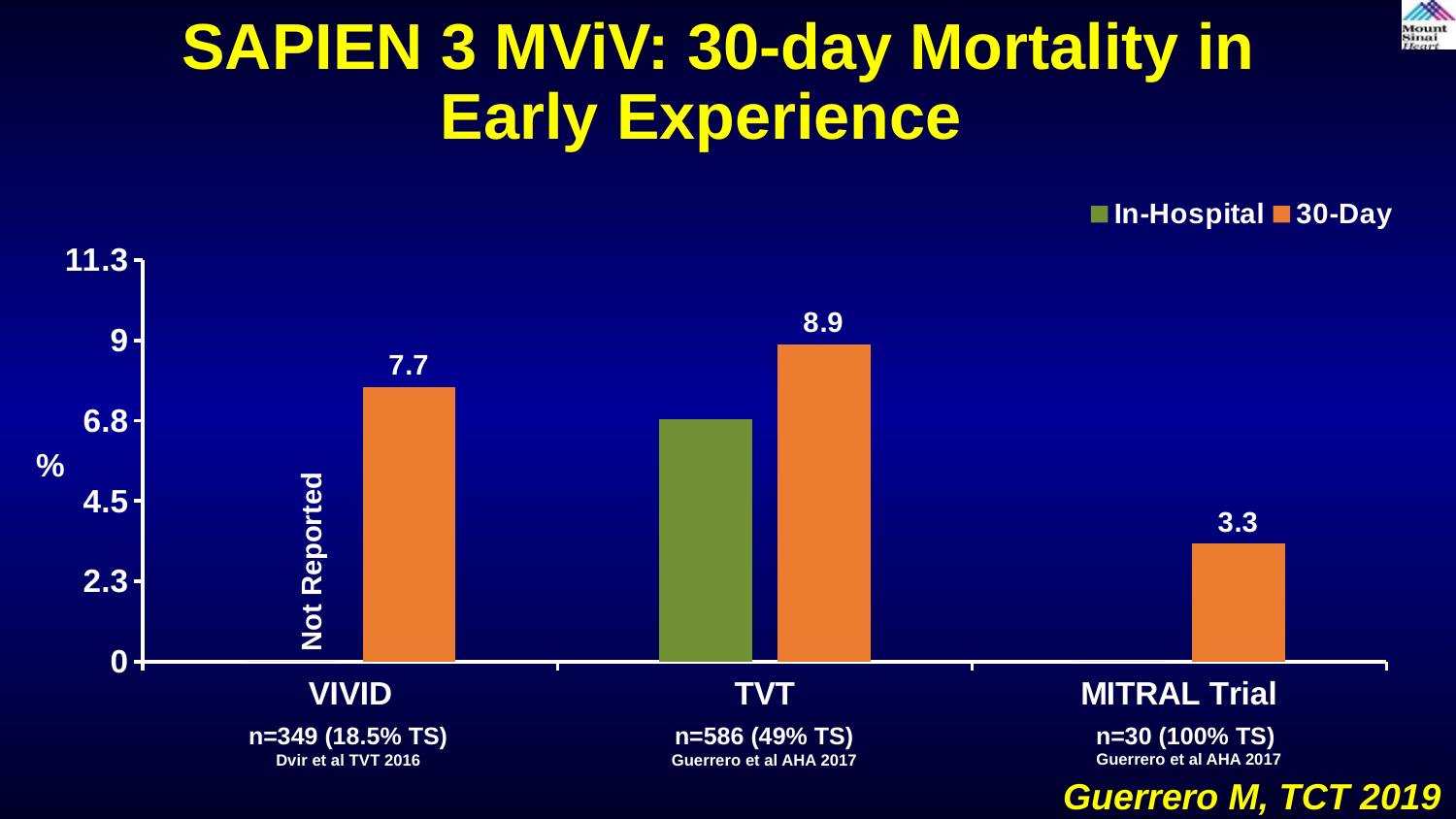
Which category has the lowest 30-Day mortality? MITRAL Trial What is the 30-Day mortality value for VIVID? 7.7 What kind of chart is shown on the slide? bar chart What is the 30-Day mortality value for the MITRAL Trial? 3.3 What is the difference between the 30-Day values for TVT and VIVID? 1.2 Is the In-Hospital value for TVT greater or less than 4.5? greater How many series does the legend list? 2 What is shown in place of the In-Hospital value for VIVID? Not Reported What is the 30-Day mortality value for TVT? 8.9 Which category has the highest 30-Day mortality? TVT How many categories are shown on the x axis? 3 Which has a larger 30-Day mortality value, VIVID or the MITRAL Trial? VIVID